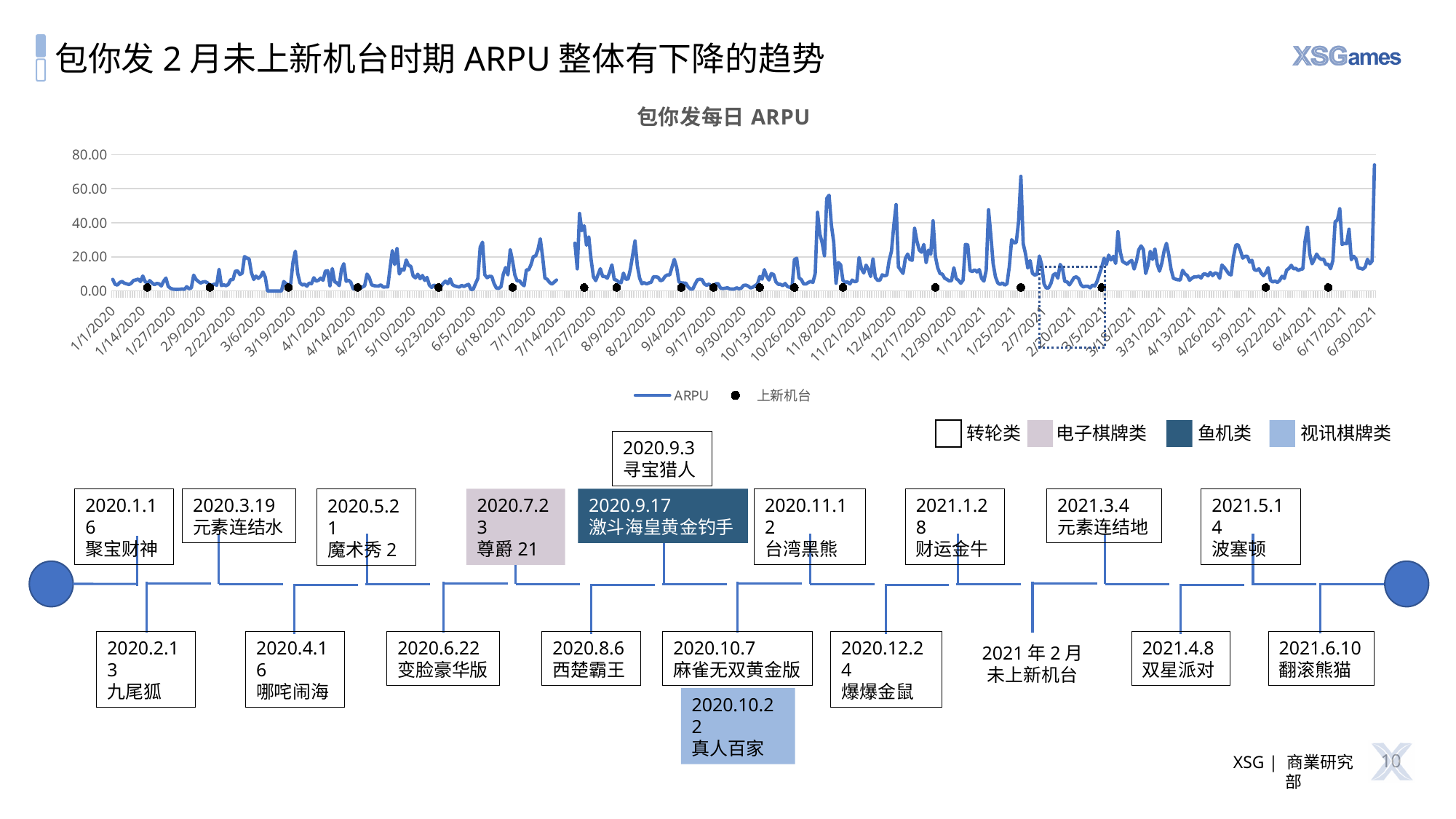
What is the title of the chart? 包你发每日 ARPU Is the ARPU peak around 1/25/2021 greater or less than 60? greater Is the ARPU value at 3/6/2020 greater or less than 40? less What is the highest value shown on the y axis of the chart? 80.00 Is the ARPU value at 1/1/2020 greater or less than 20? less What kind of chart is shown on the slide? line chart What is the first date label on the x axis of the chart? 1/1/2020 Which is larger, the ARPU value at 6/30/2021 or the ARPU value at 1/1/2020? 6/30/2021 What are the two entries in the chart legend? ARPU and 上新机台 How many series does the chart legend list? 2